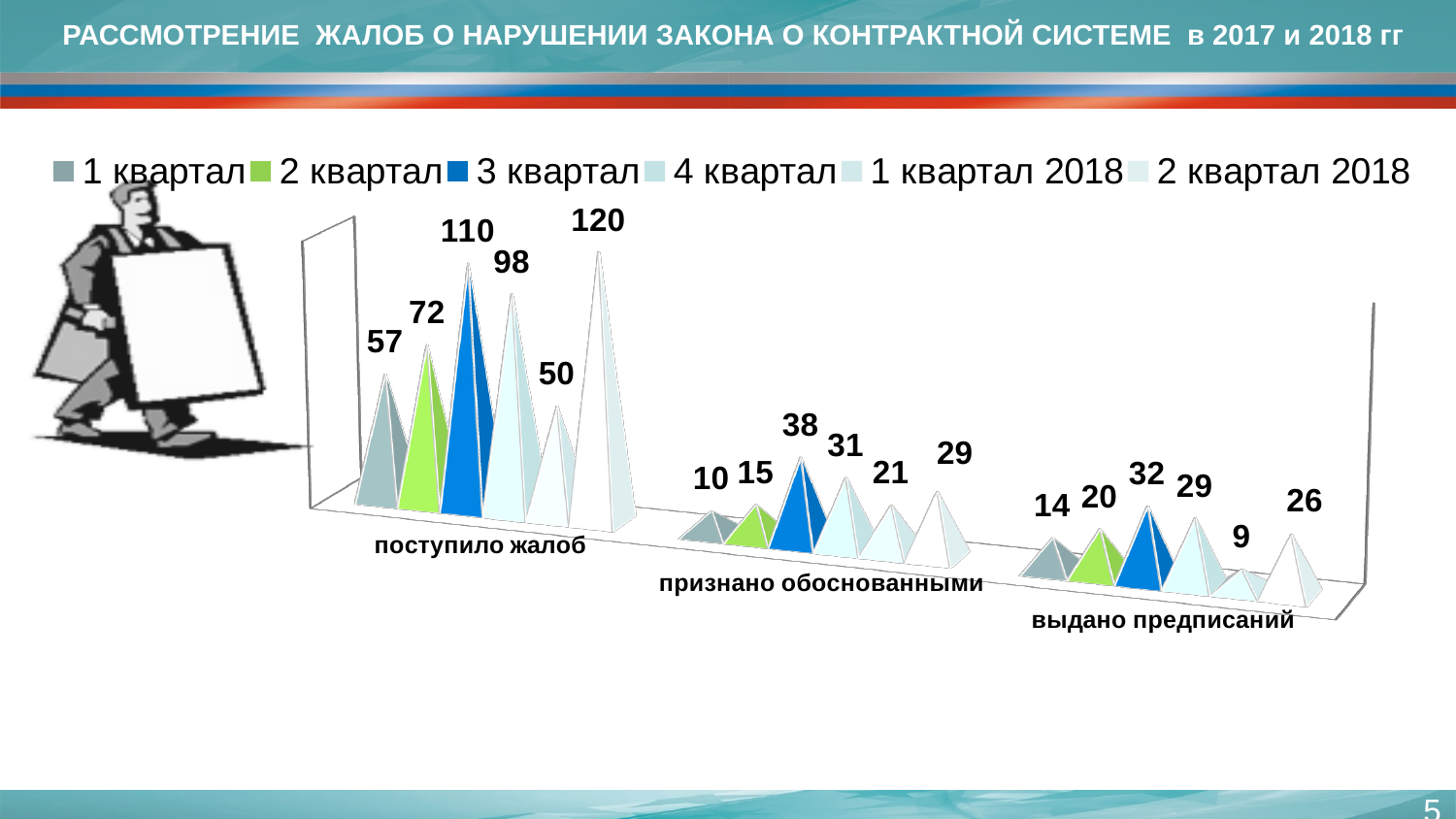
Which series has the highest value in the category поступило жалоб? 2 квартал 2018 What is the difference between the 3 квартал and 1 квартал values in the category поступило жалоб? 53 How many series does the legend list? 6 What is the value for 2 квартал 2018 in the category поступило жалоб? 120 What is the label of the first category on the x axis? поступило жалоб Which series has the lowest value in the category выдано предписаний? 1 квартал 2018 What is the difference between the 3 квартал values for признано обоснованными and выдано предписаний? 6 What is the value for 3 квартал in the category поступило жалоб? 110 What is the value for 2 квартал in the category выдано предписаний? 20 How many categories are shown along the x axis? 3 What is the value for 1 квартал in the category признано обоснованными? 10 Which is larger in the category признано обоснованными: the value for 3 квартал or the value for 2 квартал? 3 квартал